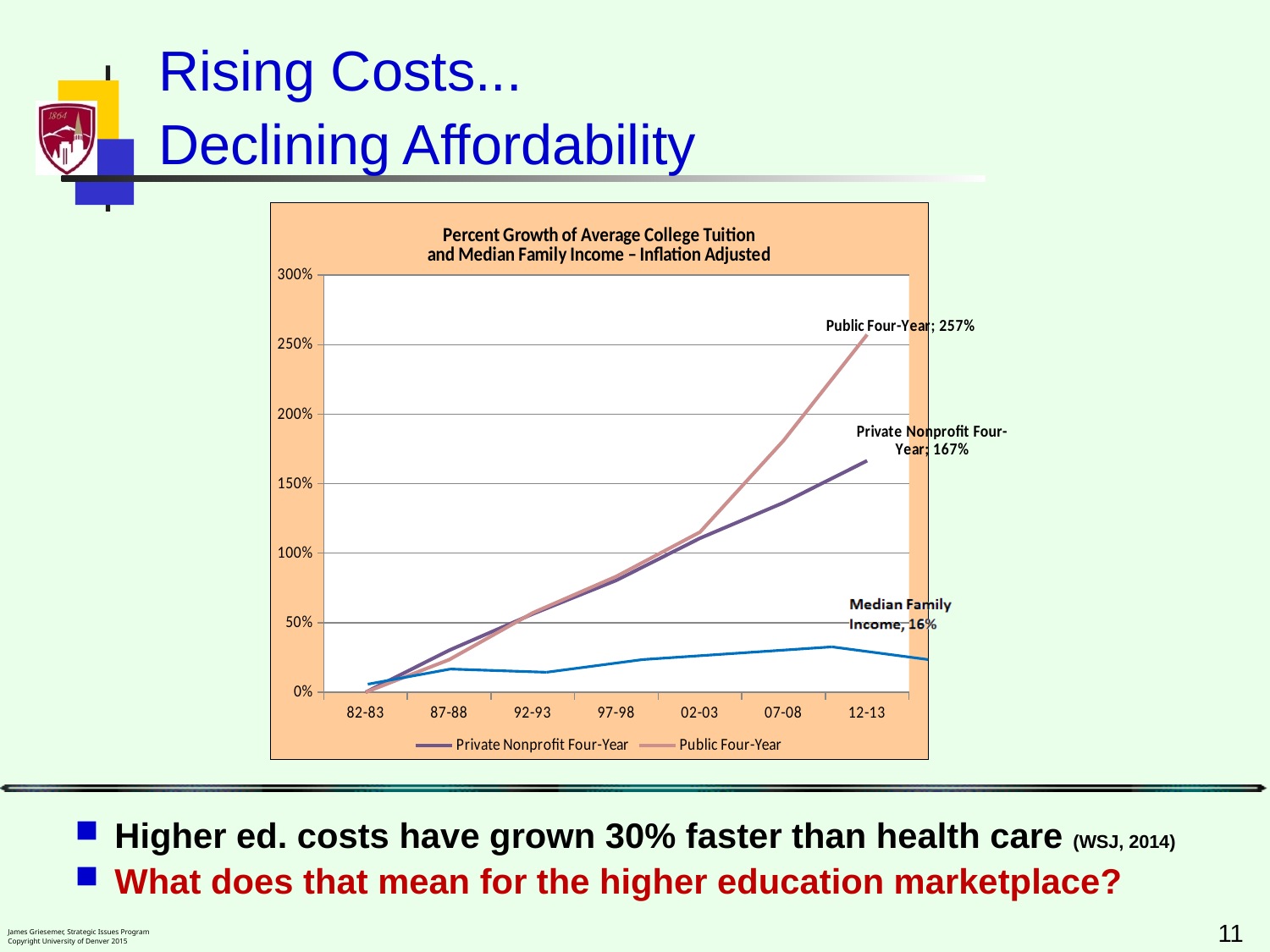
Is the value for Private Nonprofit Four-Year at 02-03 greater or less than 150%? less What is the labelled final value for Private Nonprofit Four-Year? 167% Which series has the lowest labelled final value? Median Family Income What is the labelled final value for Public Four-Year? 257% Which series has the highest labelled final value? Public Four-Year What is the labelled final value for Median Family Income? 16% What kind of chart is shown on the slide? line chart Does the Public Four-Year line rise or fall from 82-83 to 12-13? rise What is the difference between the labelled final values for Public Four-Year and Private Nonprofit Four-Year? 90 percentage points What is the title of the chart? Percent Growth of Average College Tuition and Median Family Income – Inflation Adjusted How many series does the legend list? 2 Which is larger at the end of the chart, Public Four-Year or Private Nonprofit Four-Year? Public Four-Year